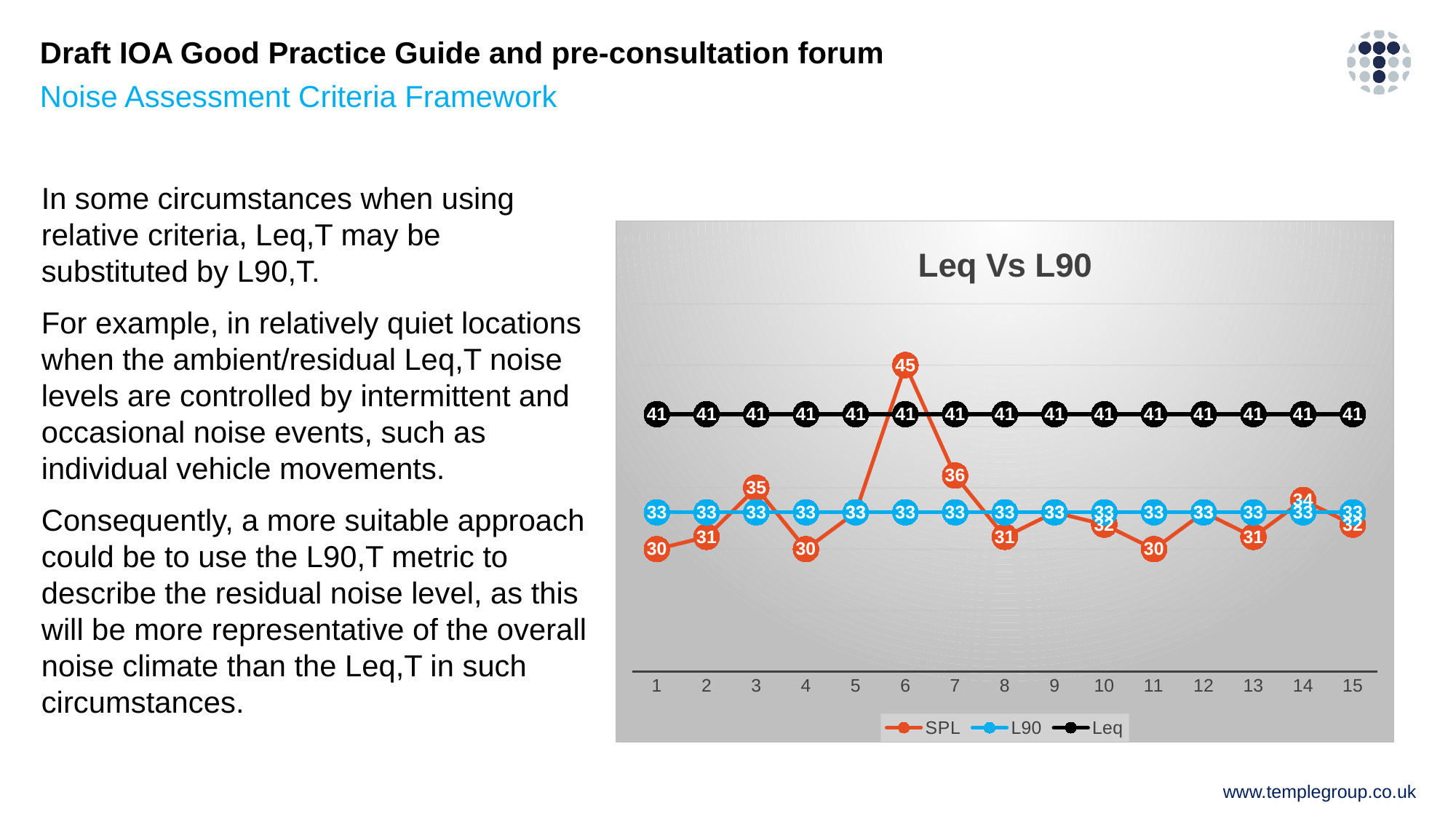
What is the SPL value at point 6? 45 What kind of chart is shown on the slide? line chart What is the L90 value at point 3? 33 Which series is drawn in black? Leq At which x-axis point is the SPL series highest? 6 Which is larger at point 3, the SPL value or the L90 value? SPL What is the SPL value at point 7? 36 What is the difference between the SPL value at point 6 and the Leq value at point 6? 4 How many points are plotted along the x axis for each series? 15 What is the title of the chart? Leq Vs L90 What is the Leq value at point 10? 41 How many series does the chart legend list? 3